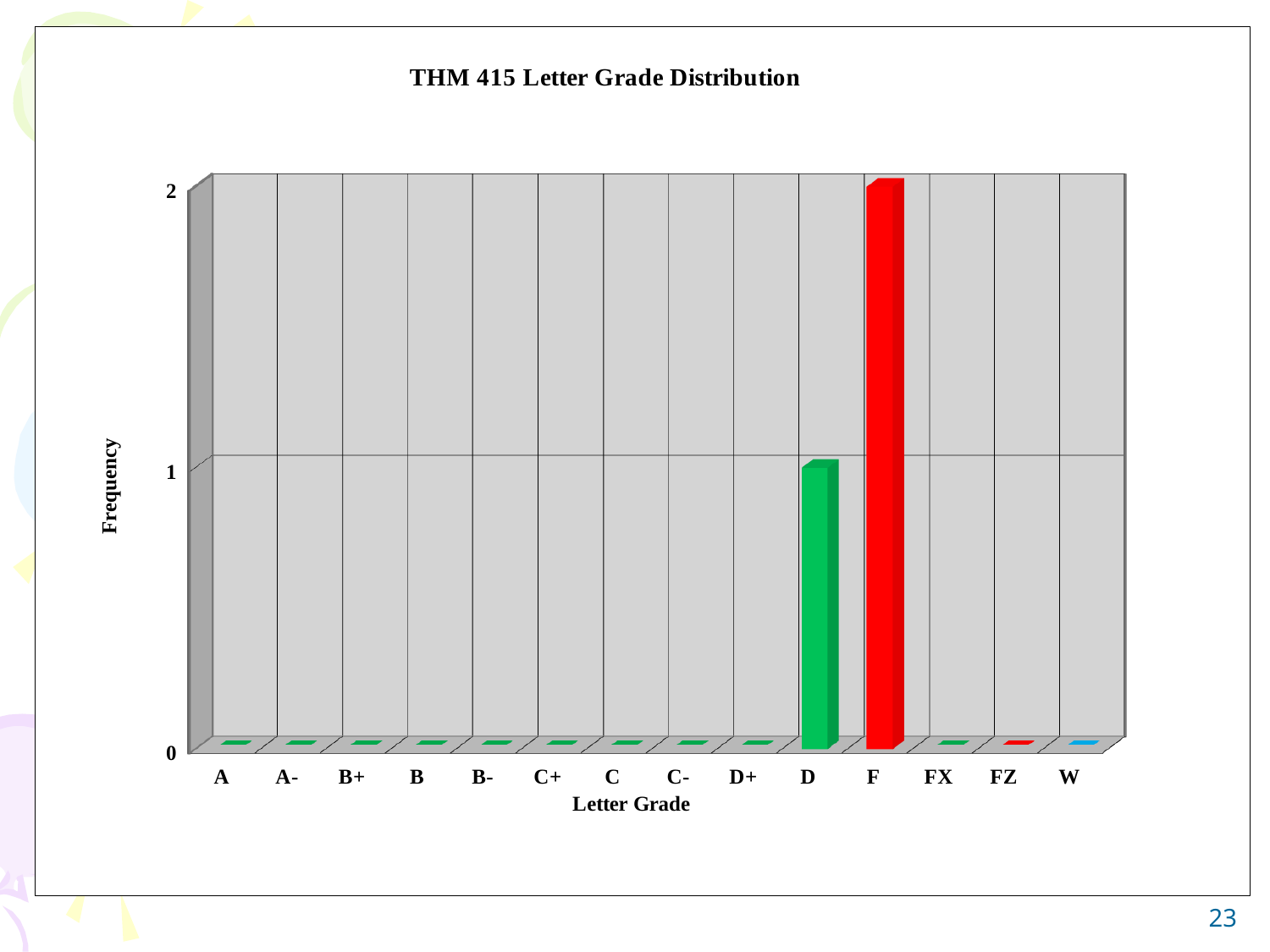
Which has a higher frequency, D or F? F What is the frequency for letter grade A? 0 What is the label of the y axis? Frequency Which letter grade has the highest frequency? F What is the frequency for letter grade D? 1 What kind of chart is shown on the slide? bar chart What is the frequency for letter grade F? 2 What is the difference in frequency between F and D? 1 What is the frequency for letter grade W? 0 What is the title of the chart? THM 415 Letter Grade Distribution How many letter grade categories are shown on the x axis? 14 Is the frequency for F greater or less than 1? greater